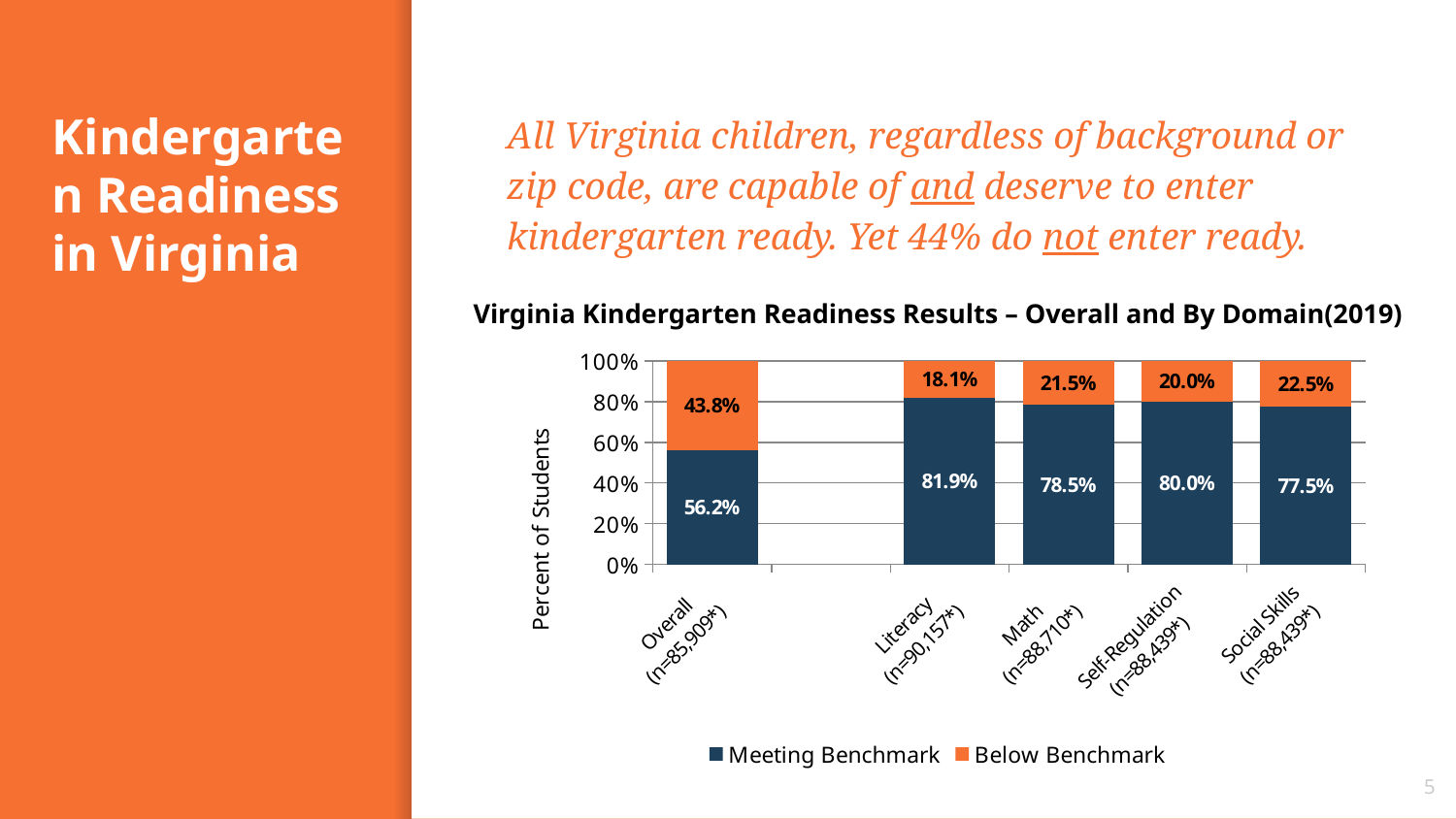
Which category has the highest Meeting Benchmark percentage? Literacy What kind of chart is shown on the slide? Stacked bar chart What percentage of students are Below Benchmark in Math? 21.5% What percentage of students are Meeting Benchmark in Literacy? 81.9% What is the Meeting Benchmark value for Overall? 56.2% How many categories are shown on the x axis? 5 What is the title of the chart? Virginia Kindergarten Readiness Results – Overall and By Domain(2019) Is the Meeting Benchmark value for Overall greater or less than 60%? less What is the difference between the Meeting Benchmark percentages for Self-Regulation and Social Skills? 2.5% Which category has the lowest Meeting Benchmark percentage? Overall How many series does the legend list? 2 Which is larger, the Below Benchmark value for Social Skills or for Literacy? Social Skills